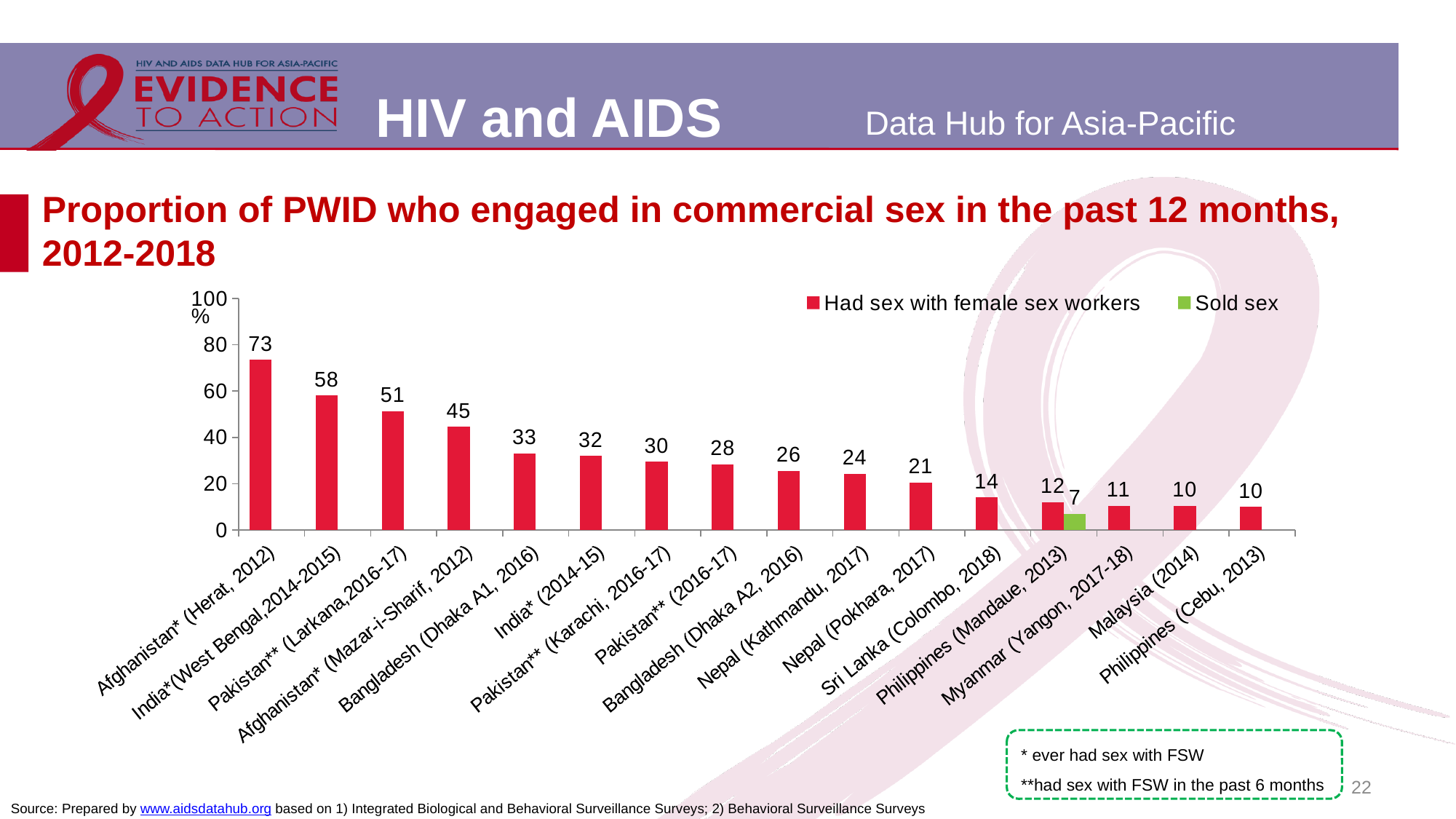
What kind of chart is shown on the slide? Bar chart How many categories are shown on the x axis? 16 Which is larger: the value for Bangladesh (Dhaka A1, 2016) or Bangladesh (Dhaka A2, 2016)? Bangladesh (Dhaka A1, 2016) Which series is shown in green in the legend? Sold sex Which category has the highest value for 'Had sex with female sex workers'? Afghanistan* (Herat, 2012) What is the value for Sri Lanka (Colombo, 2018)? 14 What is the difference between the values for India*(West Bengal,2014-2015) and Pakistan** (Larkana,2016-17)? 7 What is the 'Sold sex' value for Philippines (Mandaue, 2013)? 7 What is the value for Afghanistan* (Herat, 2012) for 'Had sex with female sex workers'? 73 Do the 'Had sex with female sex workers' values generally rise or fall from left to right along the x axis? Fall What is the value for Nepal (Kathmandu, 2017)? 24 How many series does the legend list? 2